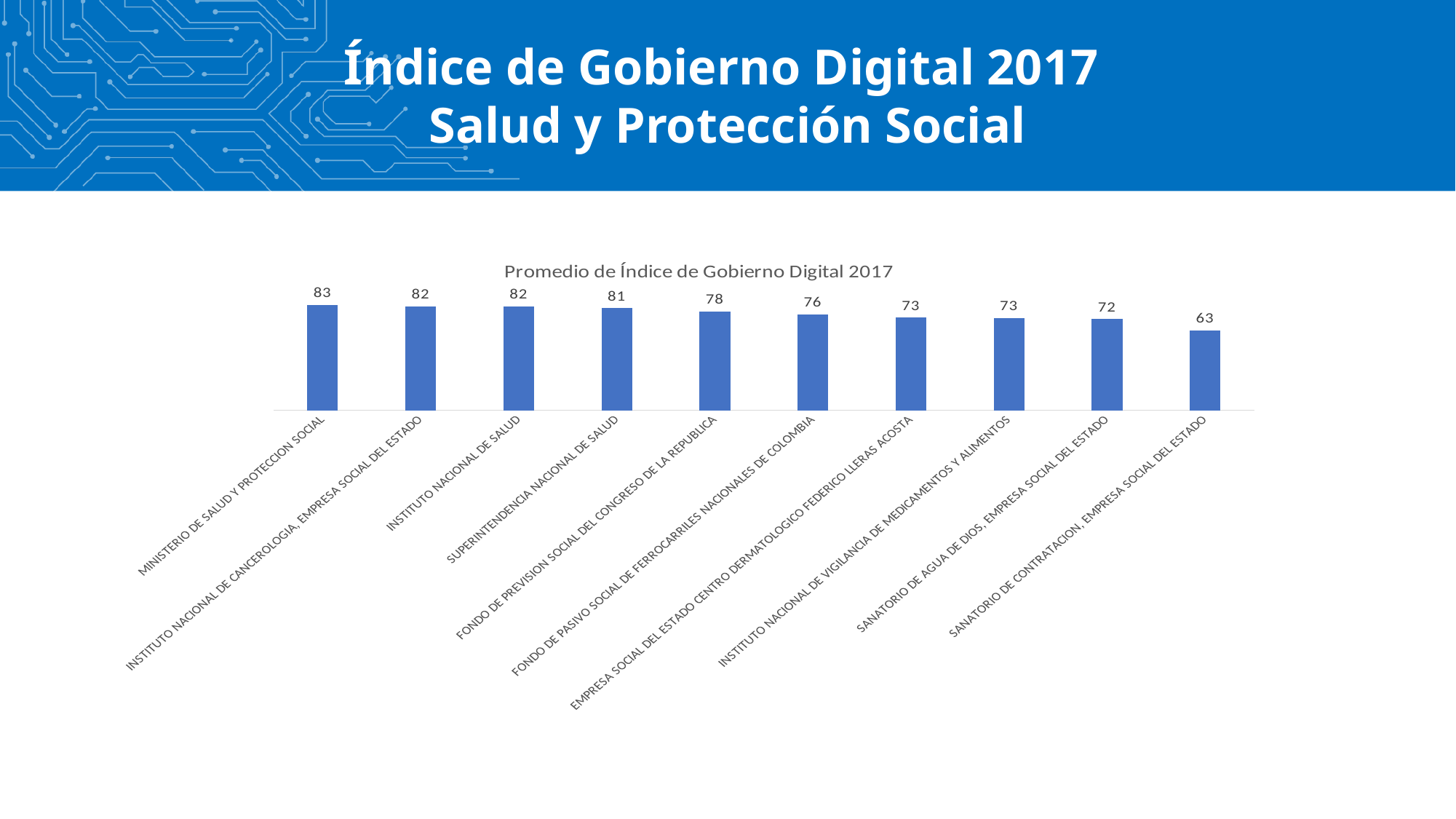
What kind of chart is shown on the slide? Bar chart Which category has the highest value? MINISTERIO DE SALUD Y PROTECCION SOCIAL Which category has the lowest value? SANATORIO DE CONTRATACION, EMPRESA SOCIAL DEL ESTADO What is the value for SANATORIO DE CONTRATACION, EMPRESA SOCIAL DEL ESTADO? 63 What is the difference between the values for SUPERINTENDENCIA NACIONAL DE SALUD and FONDO DE PASIVO SOCIAL DE FERROCARRILES NACIONALES DE COLOMBIA? 5 What is the value for FONDO DE PREVISION SOCIAL DEL CONGRESO DE LA REPUBLICA? 78 What is the value for INSTITUTO NACIONAL DE VIGILANCIA DE MEDICAMENTOS Y ALIMENTOS? 73 What is the value for MINISTERIO DE SALUD Y PROTECCION SOCIAL? 83 What is the difference between the values for MINISTERIO DE SALUD Y PROTECCION SOCIAL and SANATORIO DE CONTRATACION, EMPRESA SOCIAL DEL ESTADO? 20 Which is larger, the value for INSTITUTO NACIONAL DE SALUD or the value for SANATORIO DE AGUA DE DIOS, EMPRESA SOCIAL DEL ESTADO? INSTITUTO NACIONAL DE SALUD How many categories are shown in the chart? 10 What is the title of the chart? Promedio de Índice de Gobierno Digital 2017